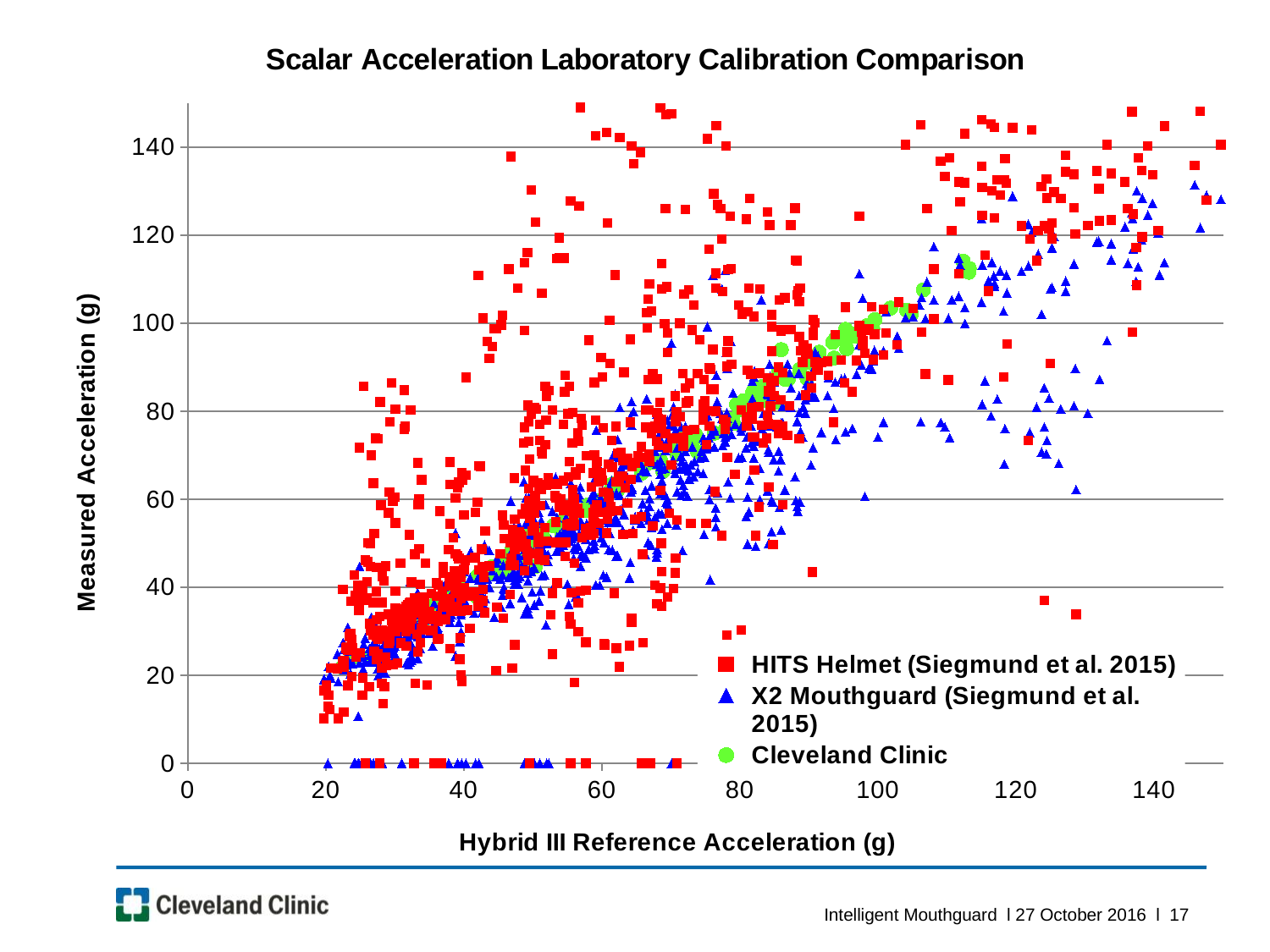
What kind of chart is shown on the slide? scatter chart As Hybrid III Reference Acceleration increases along the x axis, do the Measured Acceleration values generally rise or fall? rise Do the Cleveland Clinic points rise or fall as the reference acceleration increases? rise What is the title of the chart? Scalar Acceleration Laboratory Calibration Comparison Which series is plotted with green circles? Cleveland Clinic How many series does the legend list? 3